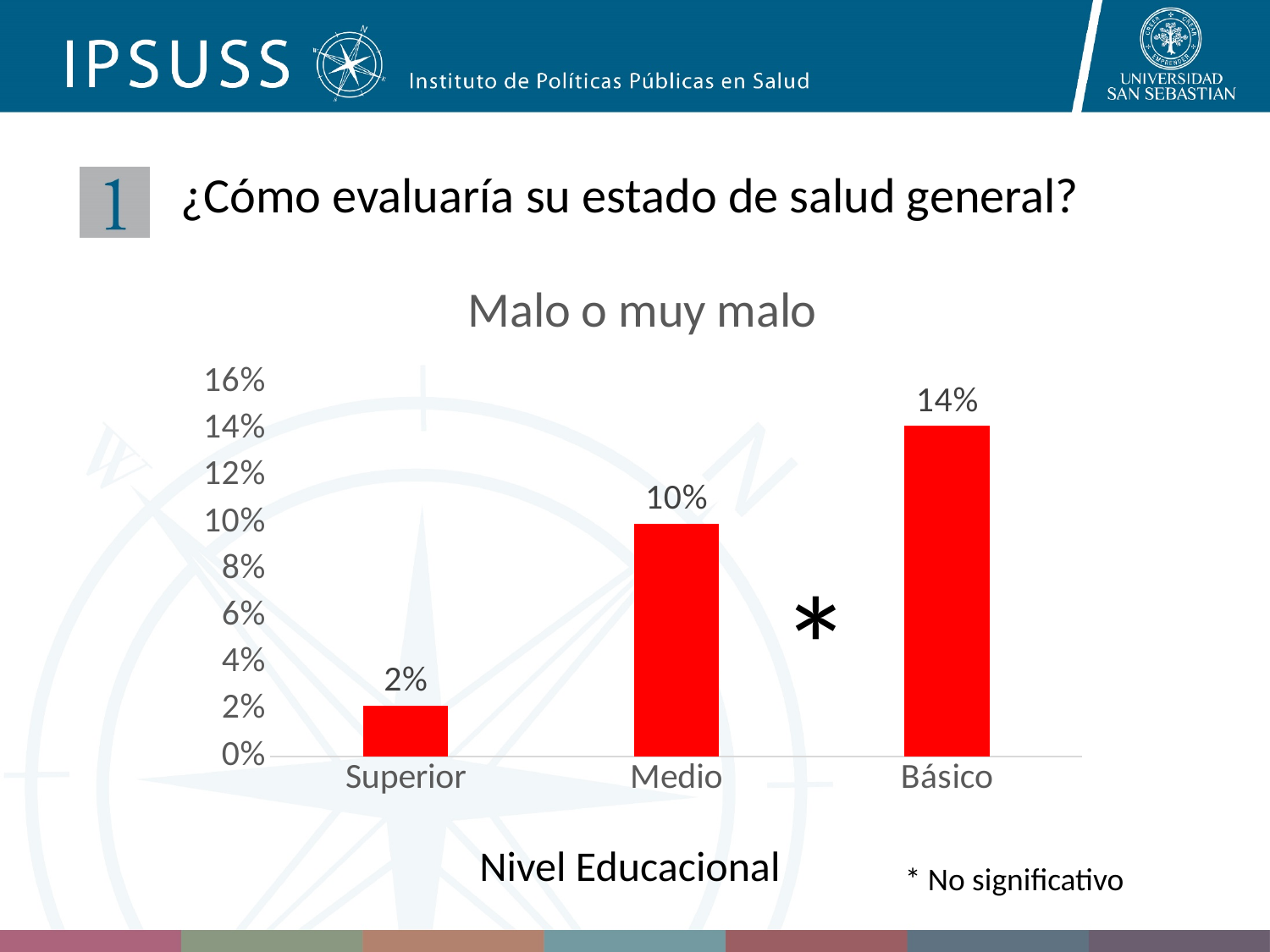
What kind of chart is shown on the slide? Bar chart Do the values rise or fall from Superior to Básico along the x axis? Rise Which educational level has the highest value? Básico Which educational level has the lowest value? Superior What is the difference between the values for Básico and Medio? 4% How many categories are shown on the x axis? 3 What is the value for Básico? 14% What is the value for Medio? 10% What is the value for Superior? 2% What is the difference between the values for Medio and Superior? 8% Which is larger, the value for Medio or the value for Superior? Medio What is the title of the chart? Malo o muy malo